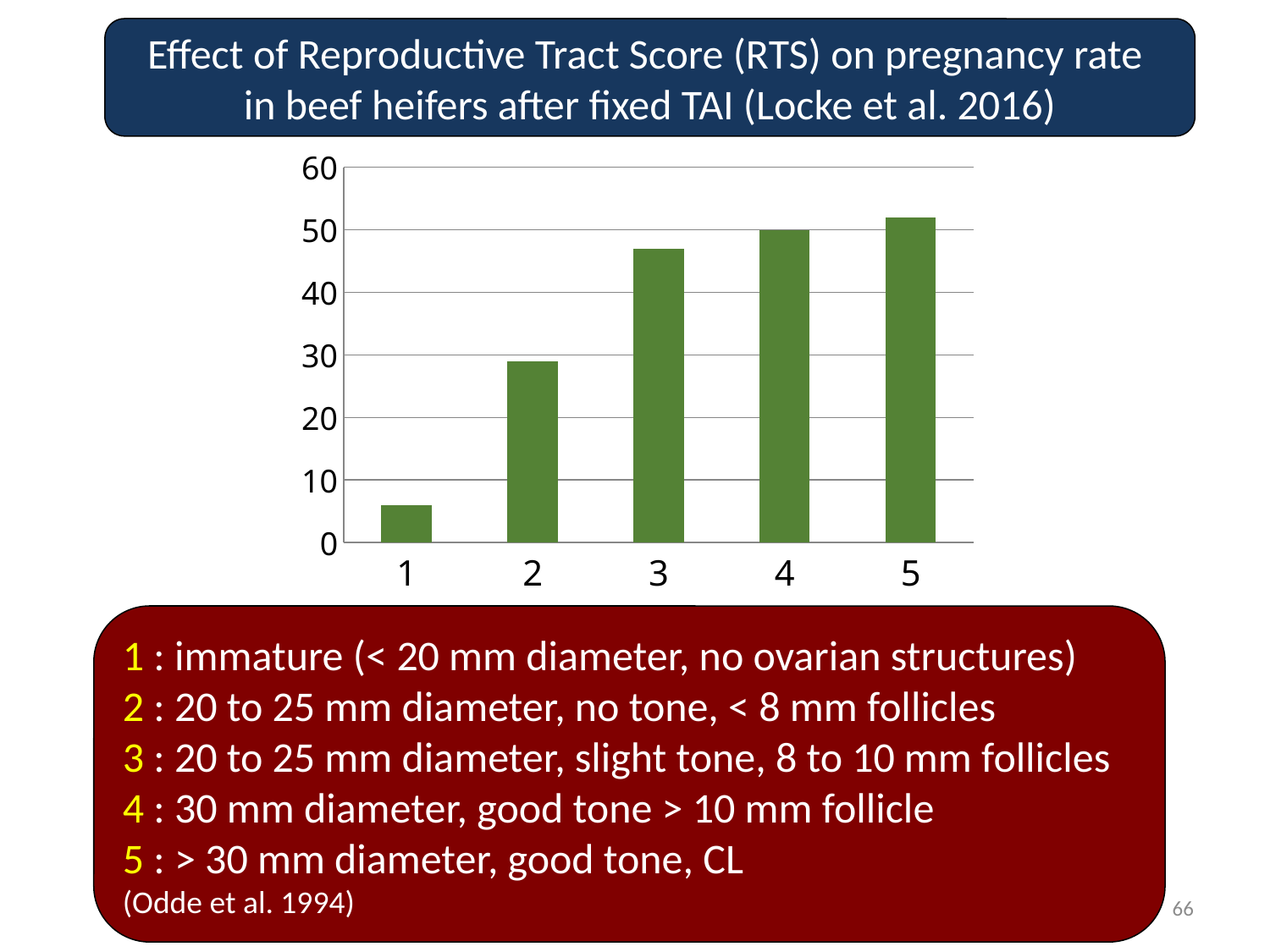
Is the value for RTS 1 greater or less than 10? less What colour are the bars in the chart? green How many categories (RTS scores) are plotted on the x axis? 5 What is the title of the slide containing the chart? Effect of Reproductive Tract Score (RTS) on pregnancy rate in beef heifers after fixed TAI (Locke et al. 2016) Which has a higher pregnancy rate, RTS 2 or RTS 3? 3 Do the values rise or fall as the RTS score increases from 1 to 5? rise Is the value for RTS 2 greater or less than 20? greater Is the value for RTS 5 greater or less than 50? greater Which RTS score has the lowest pregnancy rate? 1 What kind of chart is shown on the slide? bar chart